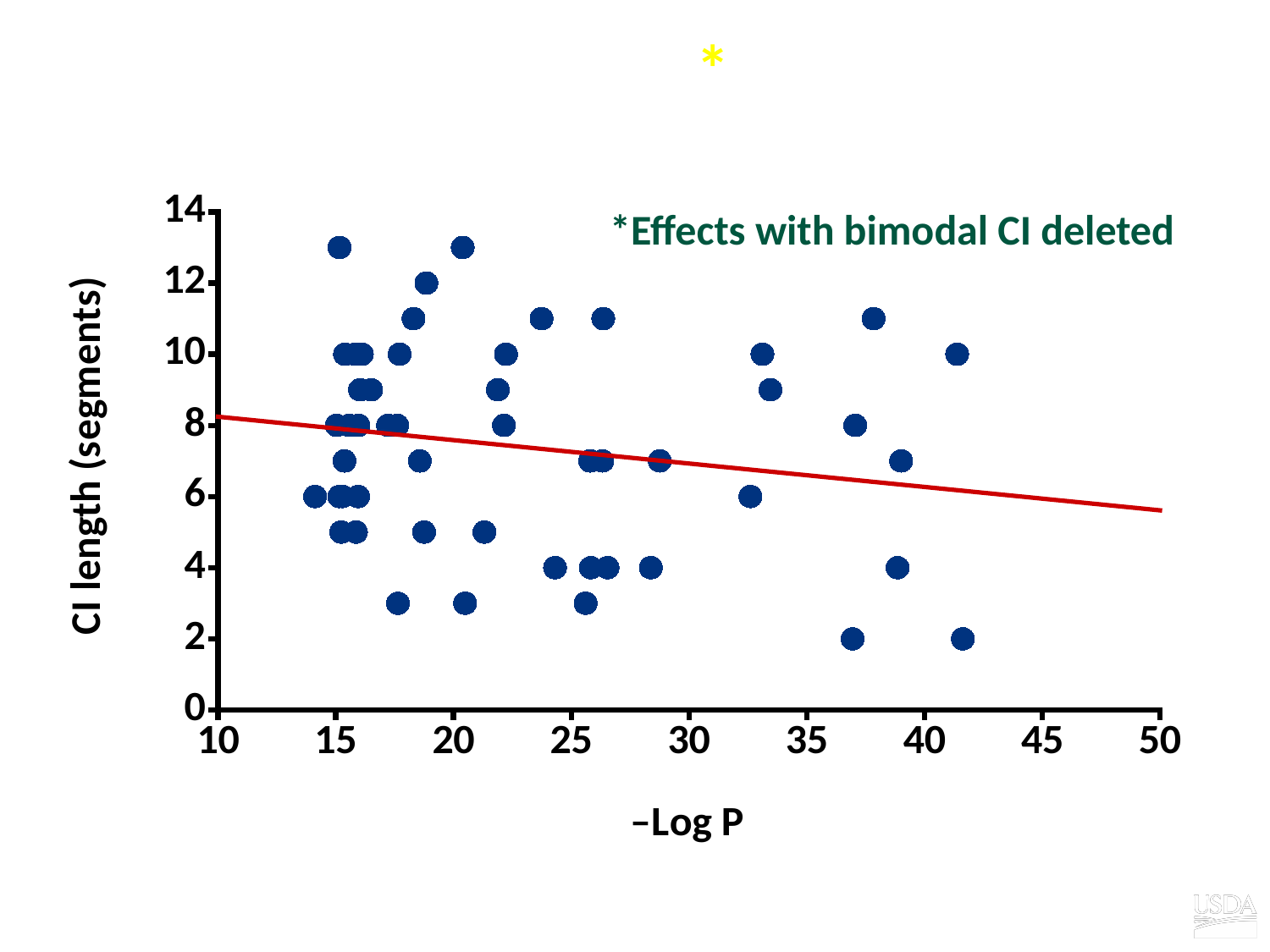
What is the label of the y axis? CI length (segments) How many plotted points have a CI length of 12? 1 Is the value of the red trend line at –Log P = 50 greater or less than 6? less Is the largest –Log P value among the plotted points greater or less than 45? less Does the fitted red line rise or fall as –Log P increases? falls Is the value of the red trend line at –Log P = 10 greater or less than 7? greater What kind of chart is shown on the slide? scatter plot How many plotted points have a CI length of 2? 2 What is the lowest CI length value among the plotted points? 2 What is the label of the x axis? –Log P